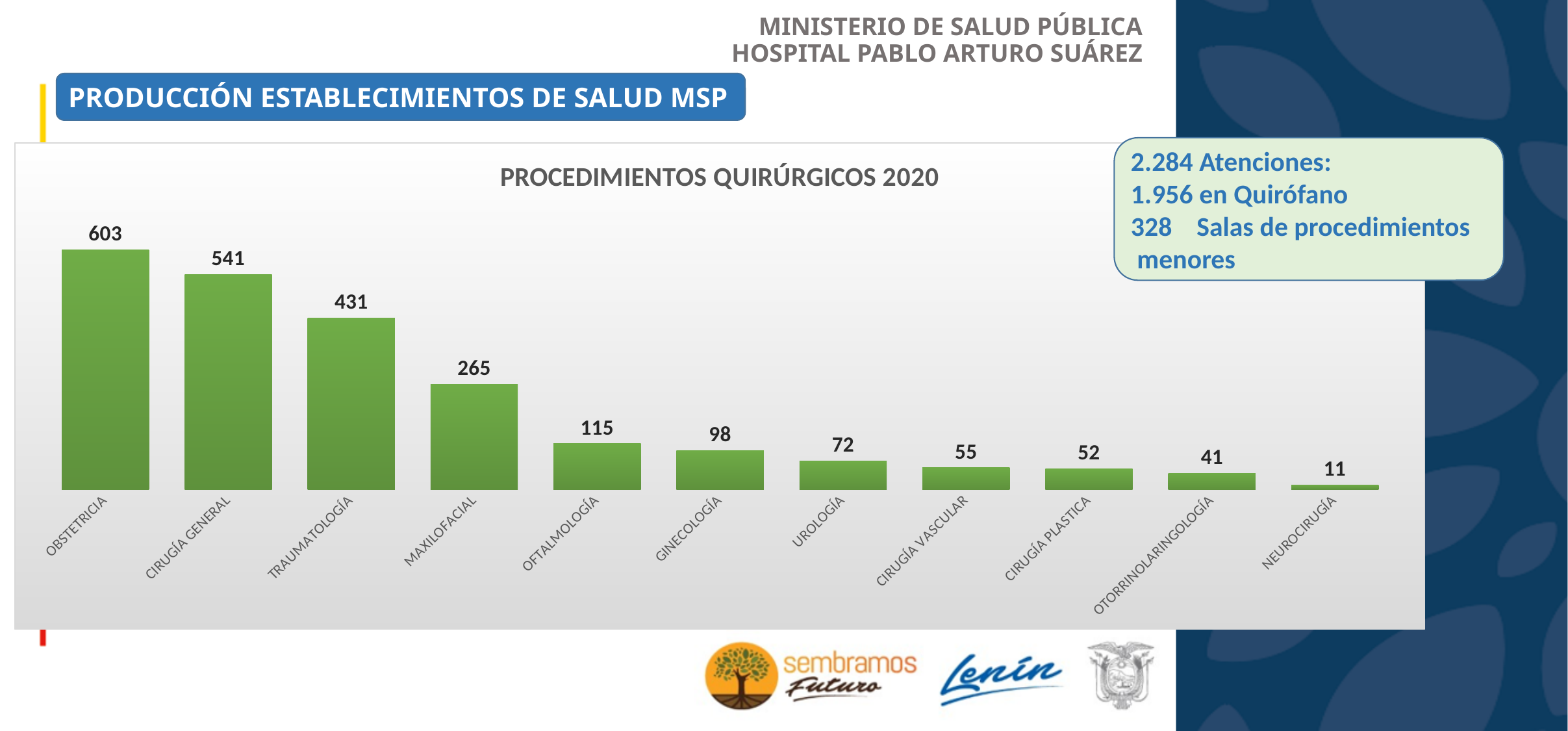
Which category has the highest value? OBSTETRICIA Do the values rise or fall from left to right along the x axis? Fall What kind of chart is shown on the slide? Bar chart What is the value for UROLOGÍA? 72 What is the title of the chart? PROCEDIMIENTOS QUIRÚRGICOS 2020 What is the difference between the values for TRAUMATOLOGÍA and MAXILOFACIAL? 166 Which category has the lowest value? NEUROCIRUGÍA What is the value for MAXILOFACIAL? 265 How many categories are shown in the chart? 11 Which is larger, the value for OFTALMOLOGÍA or the value for GINECOLOGÍA? OFTALMOLOGÍA What is the value for OBSTETRICIA in the PROCEDIMIENTOS QUIRÚRGICOS 2020 chart? 603 What is the difference between the values for OBSTETRICIA and CIRUGÍA GENERAL? 62